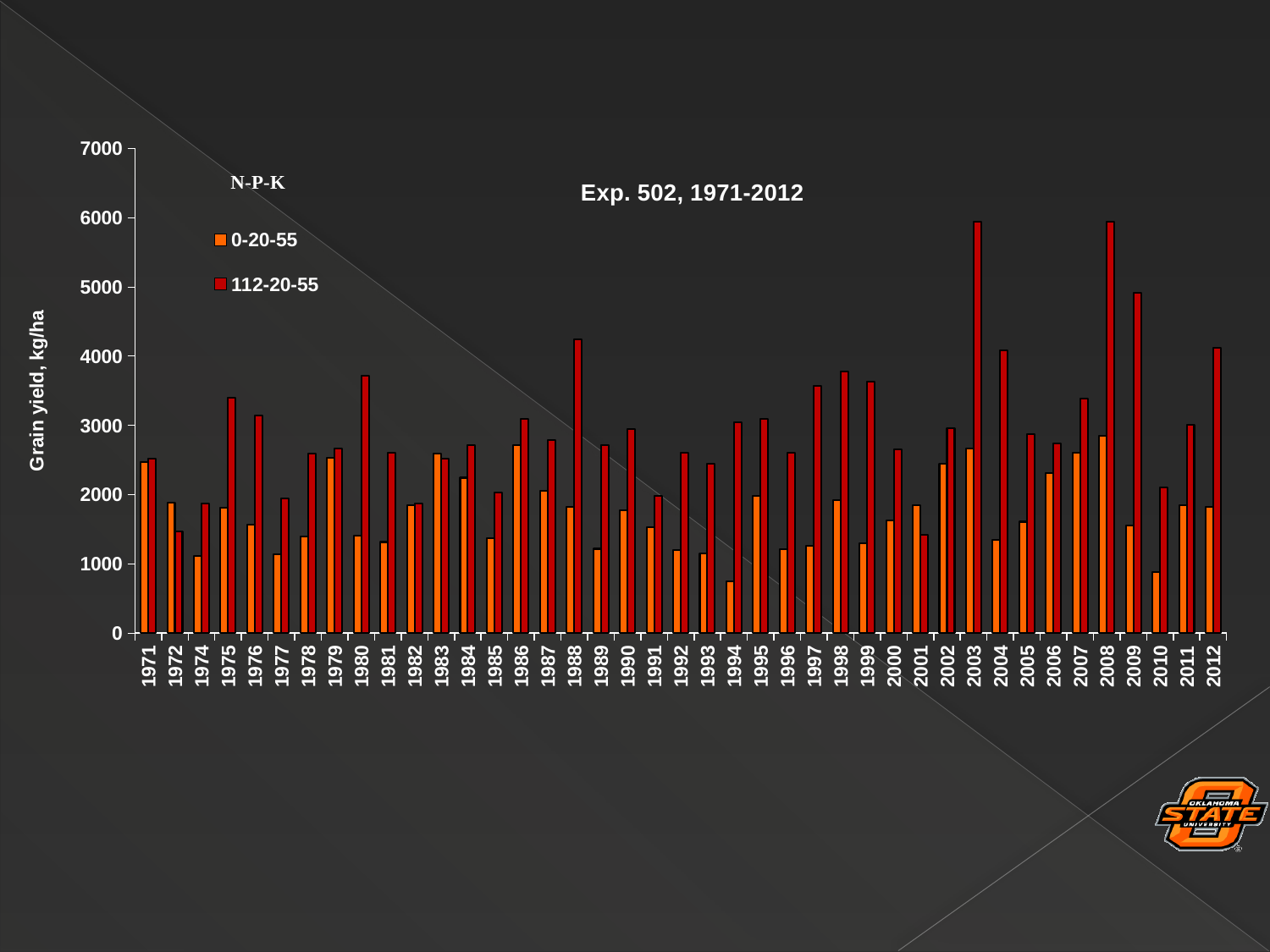
How many years are shown on the x axis? 41 In 1975, which series has the larger value, 0-20-55 or 112-20-55? 112-20-55 How many series does the legend list? 2 What is the title of the chart? Exp. 502, 1971-2012 What kind of chart is shown on the slide? bar chart Is the value for 0-20-55 in 1977 greater or less than 2000? less Is the value for 0-20-55 in 2010 greater or less than 1000? less Is the value for 112-20-55 in 1988 greater or less than 4000? greater Which year has the lowest value for the 0-20-55 series? 1994 For the 112-20-55 series, which year has the larger value, 1980 or 1976? 1980